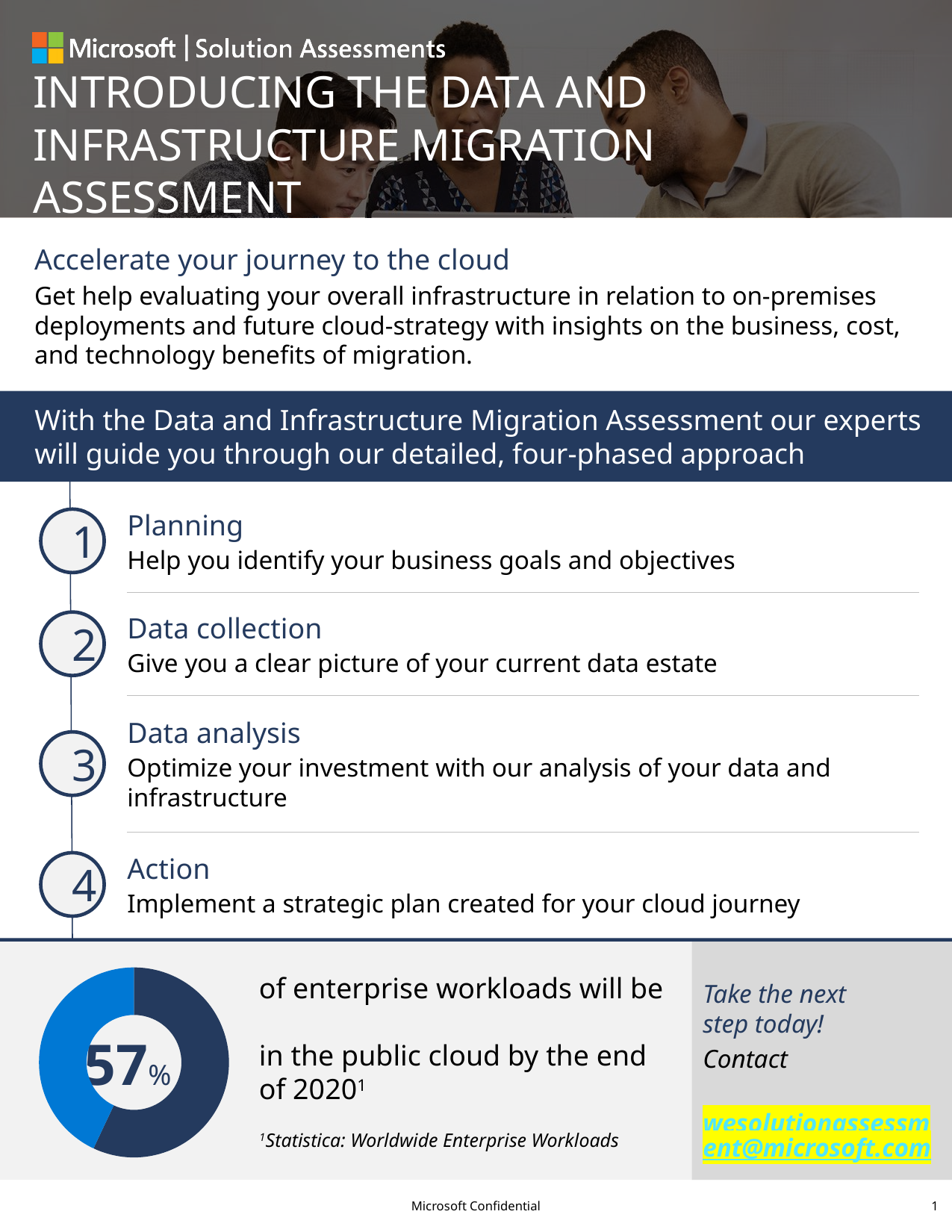
What kind of chart is shown at the bottom left of the slide? Pie chart (donut) Is the value highlighted in the donut chart greater or less than 50%? greater What percentage is printed in the centre of the donut chart? 57% Which slice of the donut chart is larger, the dark blue one or the light blue one? The dark blue one What source is cited for the 57% statistic shown with the donut chart? Statistica: Worldwide Enterprise Workloads According to the text next to the donut chart, what does the 57% figure represent? Enterprise workloads that will be in the public cloud by the end of 2020 How many slices does the donut chart have? 2